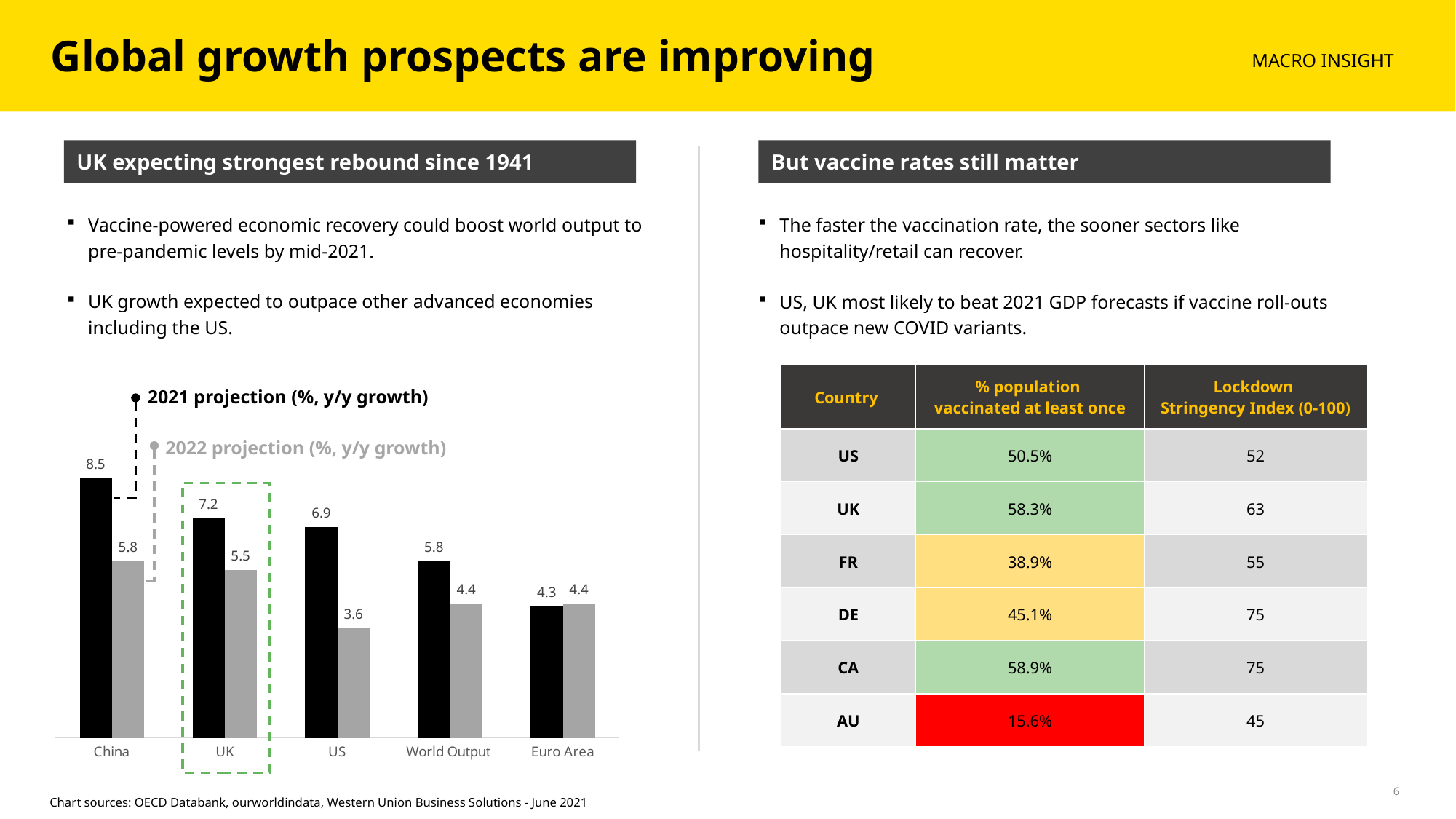
Which category on the chart is highlighted with a dashed green box? UK How many series does the chart's legend list? 2 What is the 2021 projection (%, y/y growth) for China? 8.5 How many categories are shown on the x axis of the chart? 5 What is the difference between the 2021 and 2022 projections for the UK? 1.7 Which category has the highest 2021 projection? China Which category has the lowest 2022 projection? US Do the 2021 projection values rise or fall from China to Euro Area along the x axis? Fall What kind of chart is shown on the slide? Bar chart Which is larger for the Euro Area, the 2021 projection or the 2022 projection? 2022 projection What is the 2022 projection (%, y/y growth) for the US? 3.6 What is the 2021 projection (%, y/y growth) for World Output? 5.8